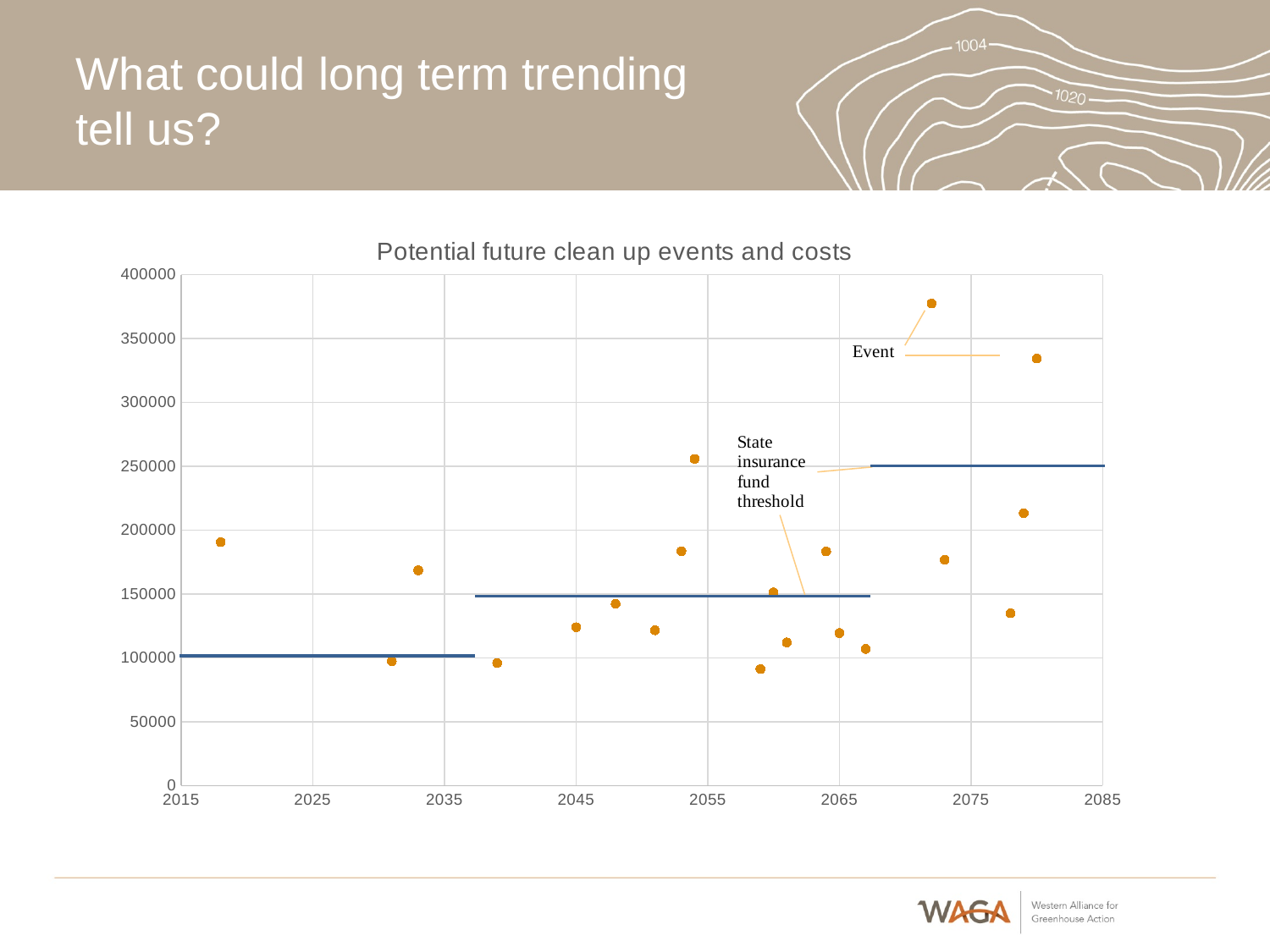
Does the state insurance fund threshold line rise or fall as the years increase? Rises Is the value of the event plotted near 2018 greater or less than 150000? greater Is the value of the highest event (near 2073) greater or less than 350000? greater What kind of chart is shown on the slide? Scatter chart What do the orange dots on the chart represent, according to the label? Event Is the value of the event plotted near 2059 greater or less than 100000? less What is the maximum value shown on the vertical axis? 400000 Which event has the higher cost: the one plotted near 2073 or the one plotted near 2080? The one near 2073 How many event points are plotted on the chart? 20 What is the title of the chart? Potential future clean up events and costs